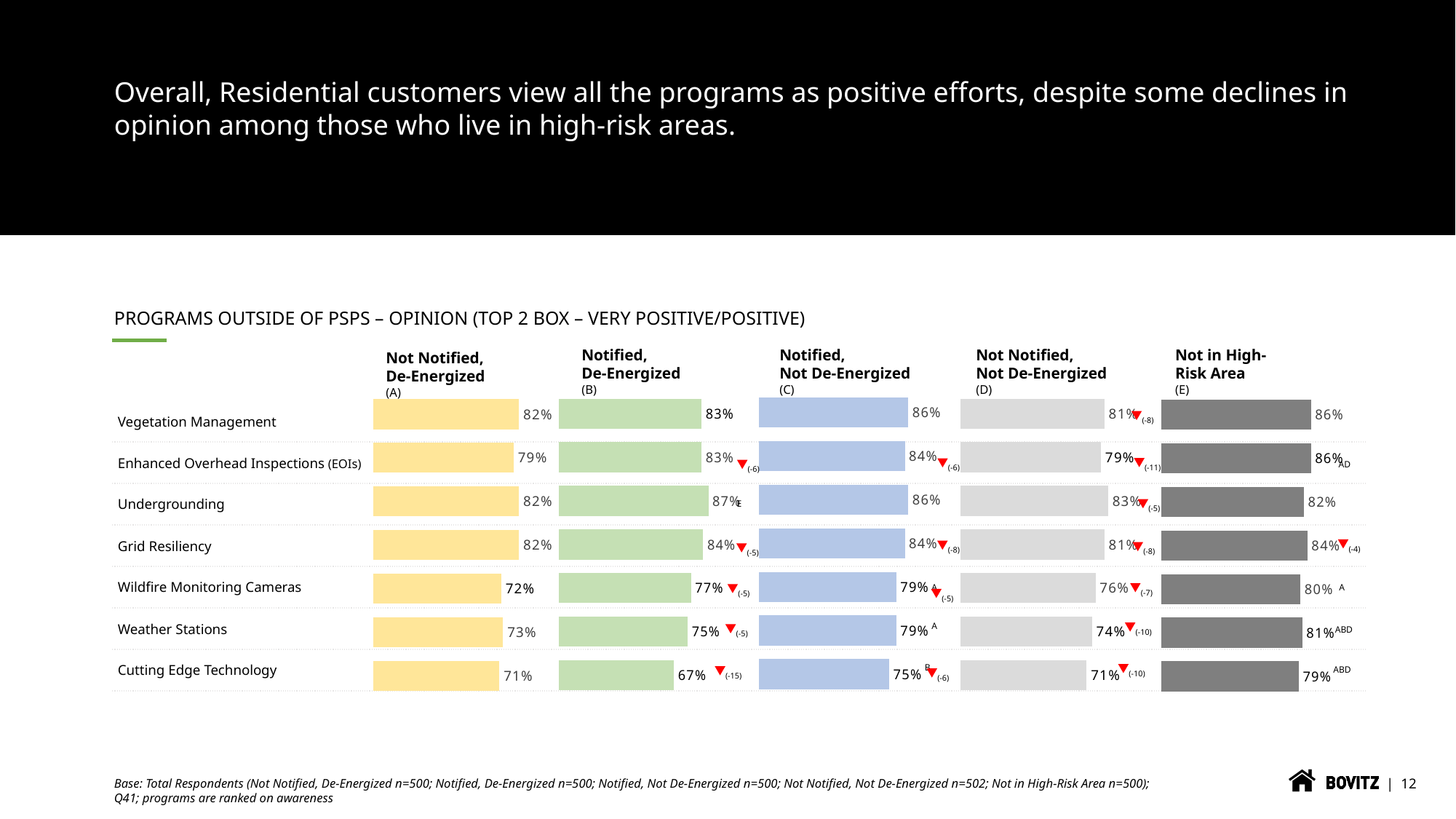
In the "Notified, De-Energized" chart, which program has the highest value? Undergrounding In the "Notified, De-Energized" chart, which program has the lowest value? Cutting Edge Technology In the "Not in High-Risk Area" chart, what is the value for Cutting Edge Technology? 79% What type of chart is used to show the opinion values on this slide? Bar chart How many programs are listed in each chart? 7 In the "Notified, De-Energized" chart, what is the value for Undergrounding? 87% In the "Not Notified, De-Energized" chart, what is the value for Wildfire Monitoring Cameras? 72% In the "Notified, Not De-Energized" chart, what is the value for Cutting Edge Technology? 75% In the "Not Notified, Not De-Energized" chart, which program has the highest value? Undergrounding In the "Notified, Not De-Energized" chart, which is larger: Vegetation Management or Wildfire Monitoring Cameras? Vegetation Management In the "Not Notified, Not De-Energized" chart, what is the value for Weather Stations? 74% In the "Not in High-Risk Area" chart, what is the difference between Vegetation Management and Cutting Edge Technology? 7 percentage points